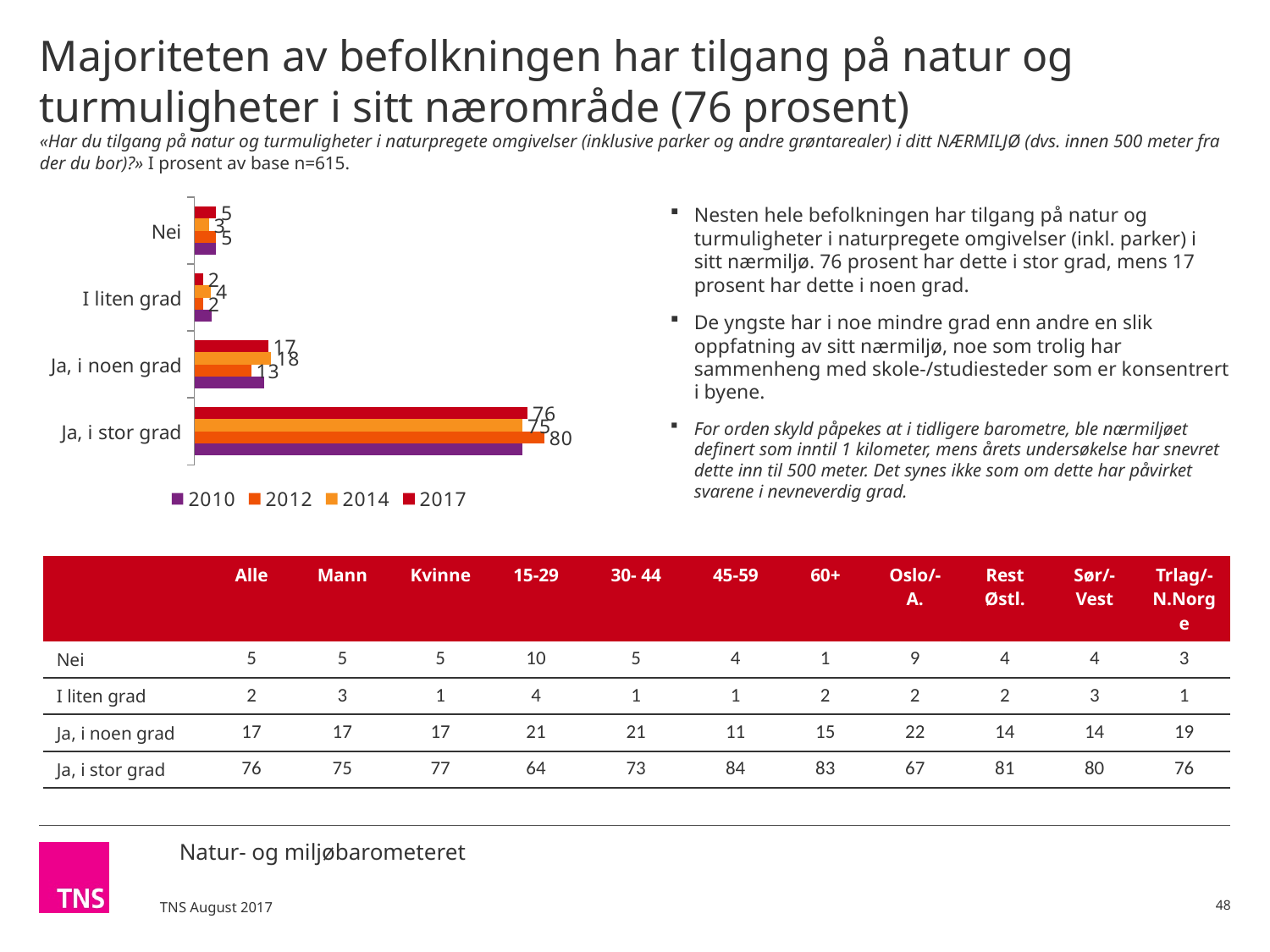
What is the 2017 value for 'Nei' in the chart? 5 Which response category has the lowest value for 2017 in the chart? I liten grad For 2017, which is larger in the chart: the value for 'Nei' or the value for 'I liten grad'? Nei How many series does the chart's legend list? 4 Which response category has the highest value for 2017 in the chart? Ja, i stor grad Which years are listed in the chart's legend? 2010, 2012, 2014, 2017 How many response categories are shown on the chart's vertical axis? 4 What is the 2017 value for 'Ja, i noen grad' in the chart? 17 What is the 2017 value for 'Ja, i stor grad' in the chart? 76 What is the difference between the 2017 values for 'Ja, i stor grad' and 'Ja, i noen grad'? 59 What is the 2017 value for 'I liten grad' in the chart? 2 What kind of chart is shown on the slide? bar chart